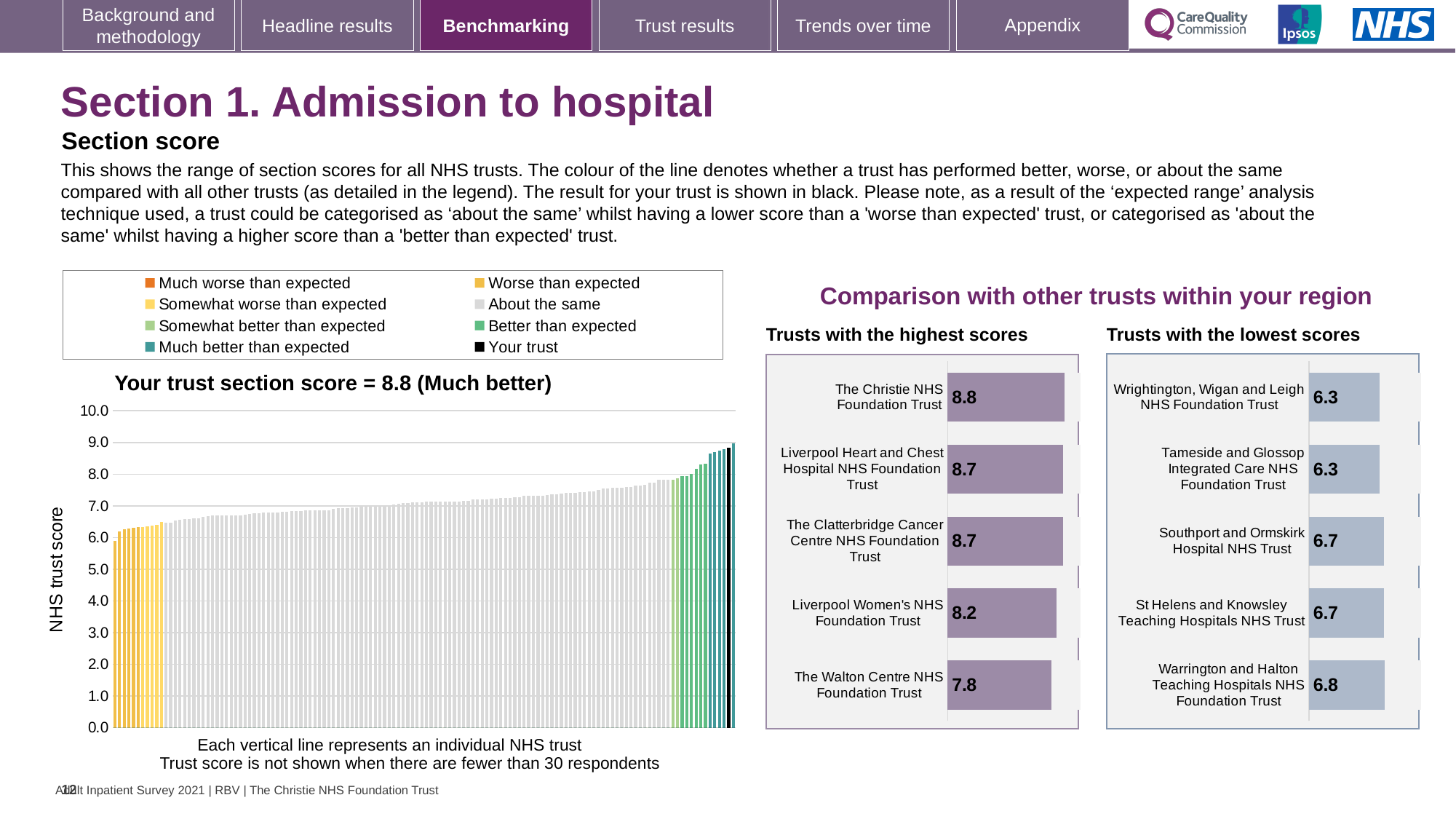
How many trusts are shown in the 'Trusts with the highest scores' chart? 5 In the 'Trusts with the lowest scores' chart, what is the score for Southport and Ormskirk Hospital NHS Trust? 6.7 In the 'Trusts with the highest scores' chart, which has the larger score: Liverpool Women's NHS Foundation Trust or The Walton Centre NHS Foundation Trust? Liverpool Women's NHS Foundation Trust In the 'Trusts with the highest scores' chart, what is the difference between the scores of The Christie NHS Foundation Trust and The Walton Centre NHS Foundation Trust? 1.0 In the 'Your trust section score = 8.8 (Much better)' chart, do the trust scores rise or fall from left to right along the x axis? Rise In the 'Trusts with the highest scores' chart, what is the score for The Christie NHS Foundation Trust? 8.8 In the 'Trusts with the highest scores' chart, which trust has the highest score? The Christie NHS Foundation Trust In the 'Trusts with the lowest scores' chart, what is the score for Warrington and Halton Teaching Hospitals NHS Foundation Trust? 6.8 In the 'Trusts with the lowest scores' chart, what is the difference between the scores of Warrington and Halton Teaching Hospitals NHS Foundation Trust and Wrightington, Wigan and Leigh NHS Foundation Trust? 0.5 In the 'Trusts with the lowest scores' chart, which trust has the highest score? Warrington and Halton Teaching Hospitals NHS Foundation Trust What kind of chart is the 'Your trust section score = 8.8 (Much better)' chart? Bar chart In the 'Trusts with the highest scores' chart, what is the score for The Walton Centre NHS Foundation Trust? 7.8